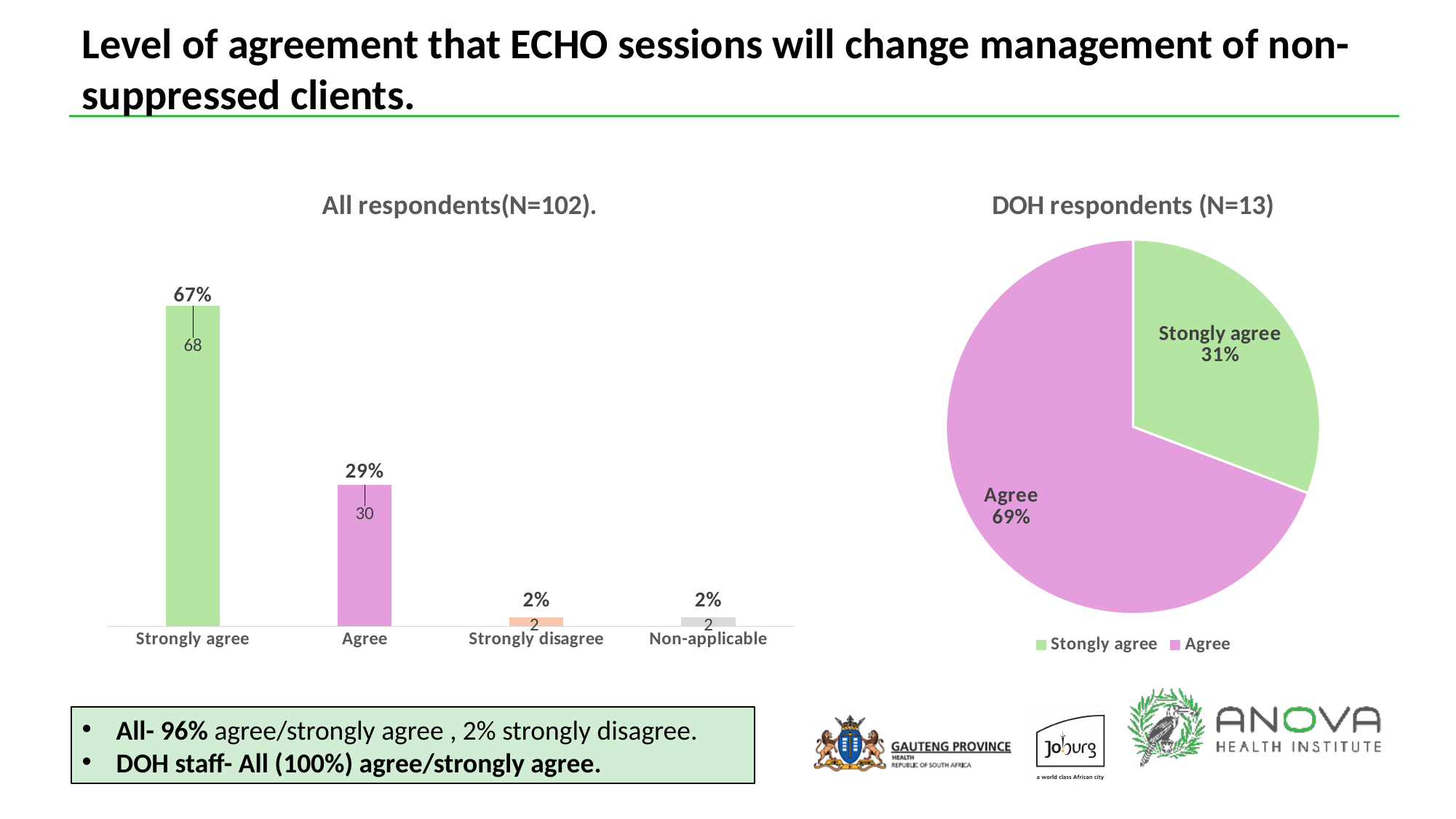
In the 'All respondents(N=102).' chart, which is larger: 'Agree' or 'Non-applicable'? Agree In the 'DOH respondents (N=13)' chart, what share of the pie is 'Agree'? 69% In the 'All respondents(N=102).' chart, what percentage of respondents chose 'Strongly disagree'? 2% In the 'All respondents(N=102).' chart, what is the difference in the number of respondents between 'Strongly agree' and 'Agree'? 38 In the 'All respondents(N=102).' chart, how many respondents chose 'Agree'? 30 In the 'All respondents(N=102).' chart, what percentage of respondents chose 'Strongly agree'? 67% What type of chart is the 'DOH respondents (N=13)' chart? Pie chart How many categories are shown in the 'All respondents(N=102).' chart? 4 In the 'DOH respondents (N=13)' chart, what share of the pie is 'Stongly agree'? 31% How many series does the legend of the 'DOH respondents (N=13)' chart list? 2 In the 'All respondents(N=102).' chart, which category has the highest value? Strongly agree What type of chart is the 'All respondents(N=102).' chart? Bar chart